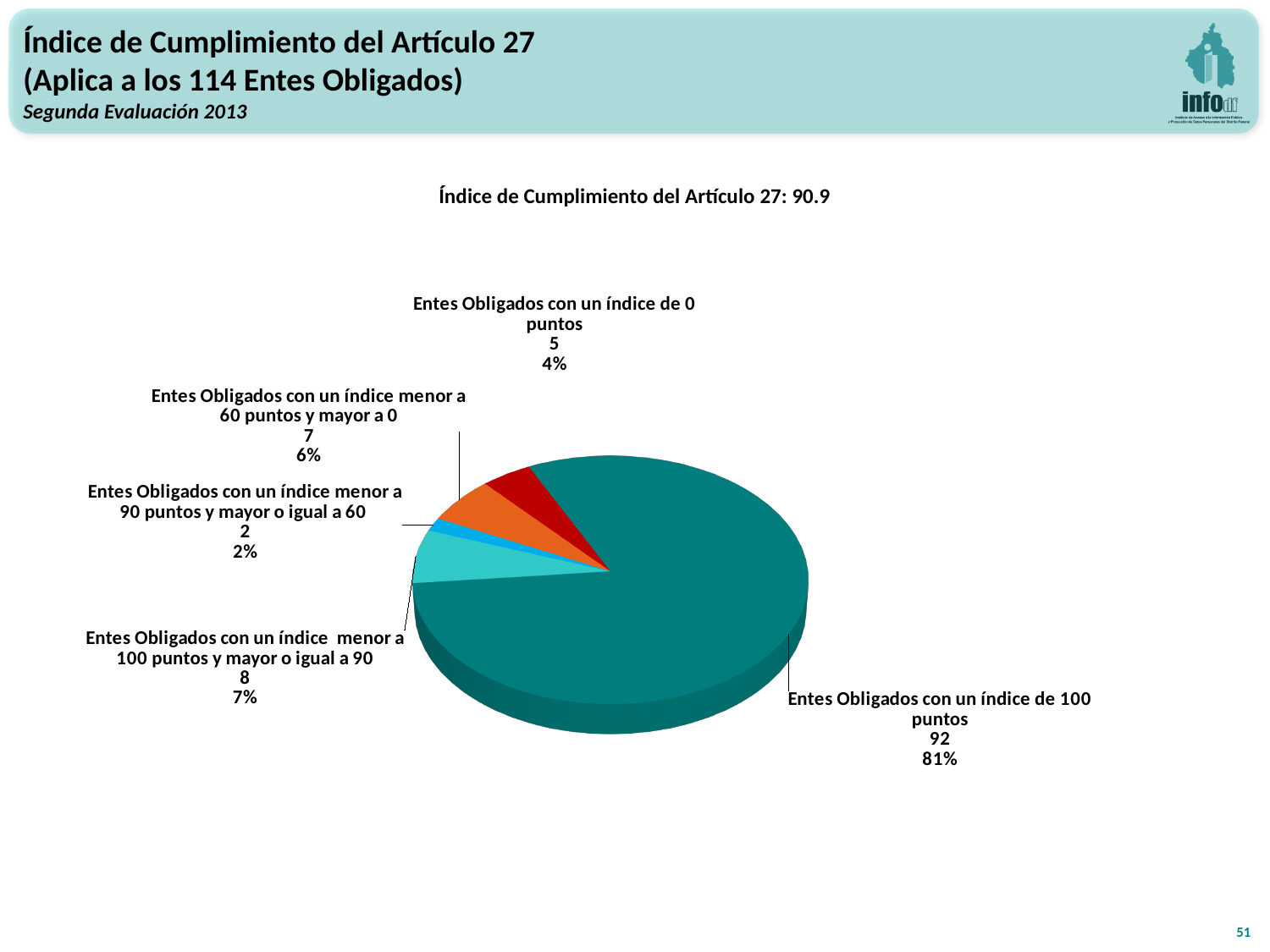
Which is larger: the number of Entes Obligados con un índice menor a 60 puntos y mayor a 0, or those con un índice de 0 puntos? Entes Obligados con un índice menor a 60 puntos y mayor a 0 How many Entes Obligados have an índice menor a 100 puntos y mayor o igual a 90? 8 Which category has the smallest slice of the pie? Entes Obligados con un índice menor a 90 puntos y mayor o igual a 60 How many categories does the pie chart have? 5 How many Entes Obligados have an índice de 0 puntos? 5 What kind of chart is shown on the slide? pie chart What share of the pie corresponds to Entes Obligados con un índice de 100 puntos? 81% What is the Índice de Cumplimiento del Artículo 27 stated in the chart title? 90.9 How many Entes Obligados have an índice de 100 puntos? 92 What is the difference between the number of Entes Obligados con un índice de 100 puntos and those con un índice de 0 puntos? 87 Which category has the largest slice of the pie? Entes Obligados con un índice de 100 puntos What percentage of the pie is Entes Obligados con un índice menor a 90 puntos y mayor o igual a 60? 2%